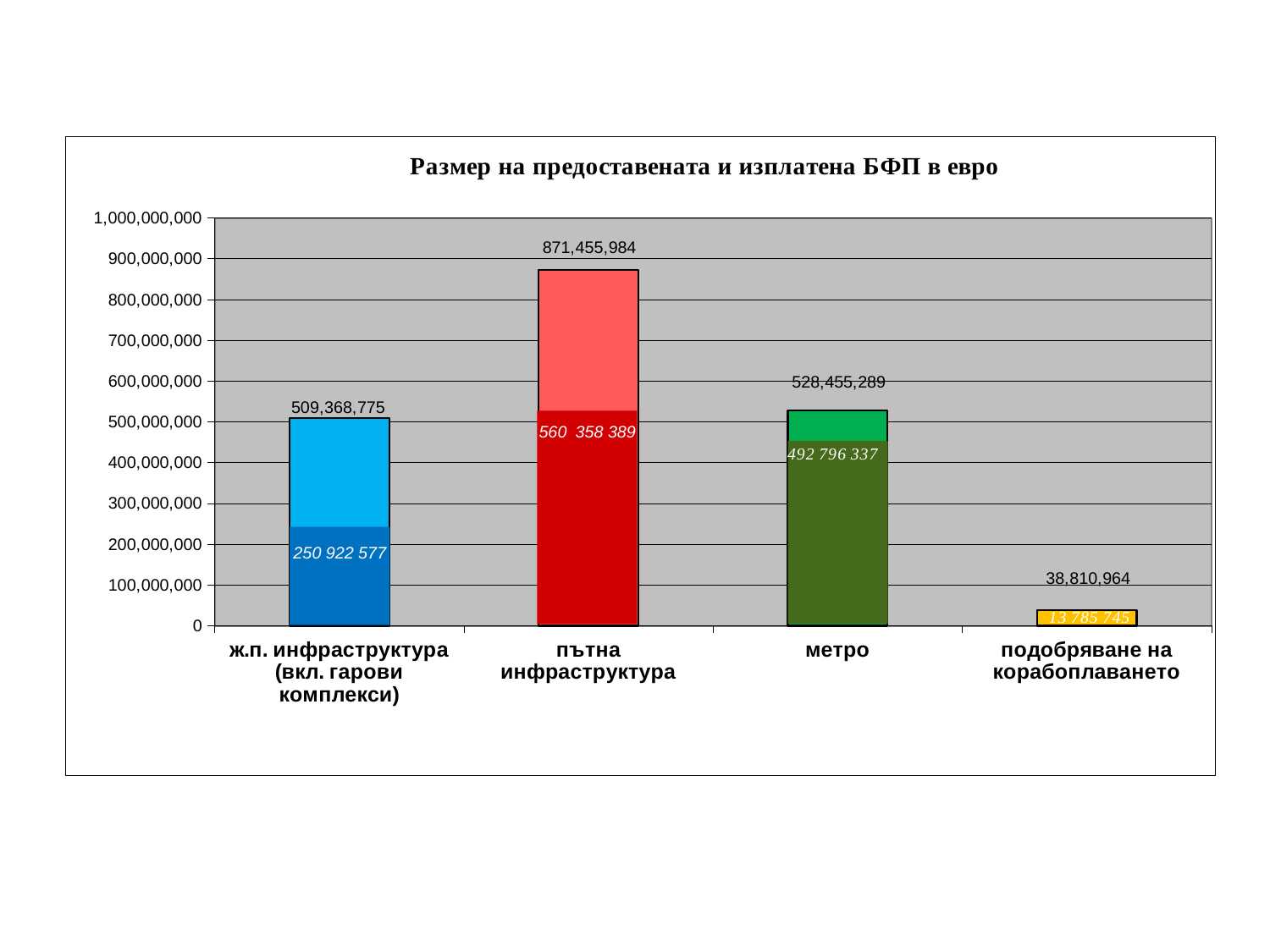
Which category has the highest value labelled above its bar? пътна инфраструктура What value is printed inside the darker part of the пътна инфраструктура bar? 560 358 389 What is the difference between the top labels of пътна инфраструктура and ж.п. инфраструктура? 362,087,209 What value is printed inside the darker part of the метро bar? 492 796 337 What is the value labelled above the bar for подобряване на корабоплаването? 38,810,964 What value is printed inside the darker part of the ж.п. инфраструктура bar? 250 922 577 What is the title of the chart? Размер на предоставената и изплатена БФП в евро What is the value labelled above the bar for пътна инфраструктура? 871,455,984 What is the value labelled above the bar for ж.п. инфраструктура (вкл. гарови комплекси)? 509,368,775 Which category has the lowest value labelled above its bar? подобряване на корабоплаването How many categories are shown on the x axis? 4 What is the value labelled above the bar for метро? 528,455,289